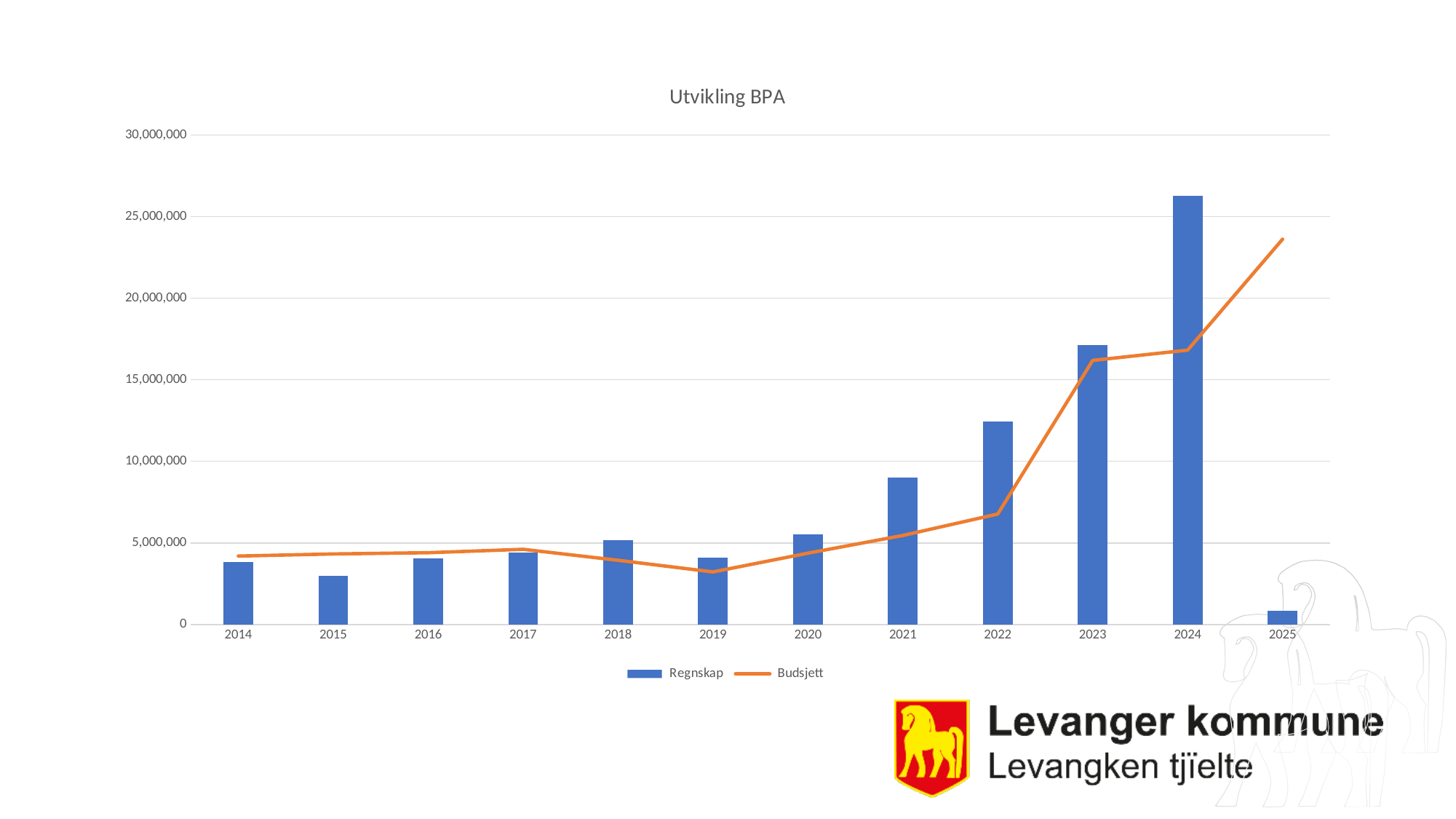
Do the Regnskap values rise or fall from 2020 to 2024? rise In 2025, which is larger, Regnskap or Budsjett? Budsjett How many series does the legend list? 2 What is the title of the chart? Utvikling BPA How many years are shown on the x axis? 12 What kind of chart is shown on the slide? A bar chart combined with a line Is the Regnskap value for 2024 greater or less than 25,000,000? greater Is the Regnskap value for 2015 greater or less than 5,000,000? less Which year has the highest Regnskap bar? 2024 Which year has the lowest Regnskap bar? 2025 Is the Budsjett value for 2025 greater or less than 20,000,000? greater In 2024, which is larger, Regnskap or Budsjett? Regnskap